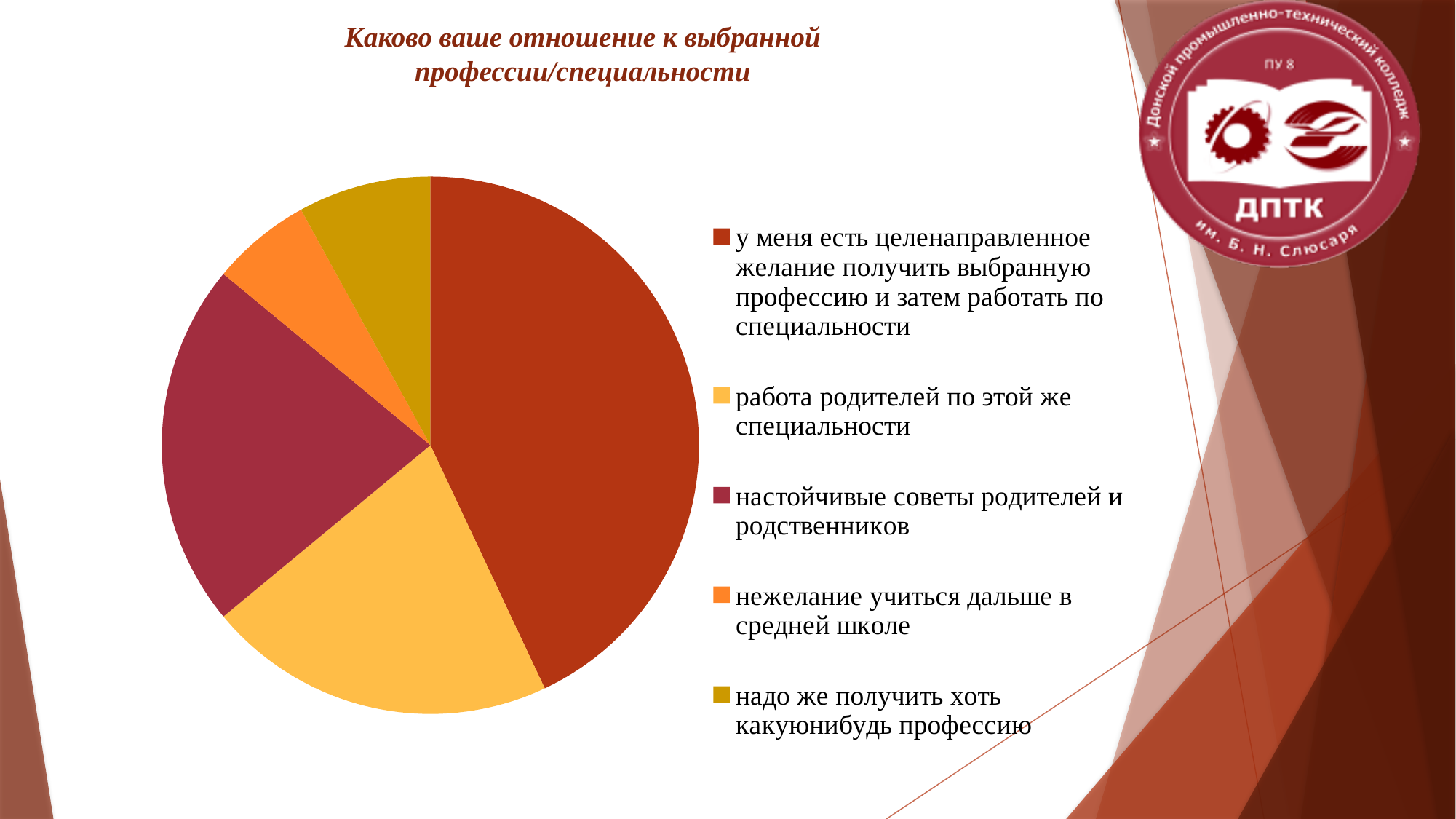
Which category has the largest slice of the pie? у меня есть целенаправленное желание получить выбранную профессию и затем работать по специальности Does the largest slice take up more or less than half of the pie? less Which slice is larger: 'работа родителей по этой же специальности' or 'нежелание учиться дальше в средней школе'? работа родителей по этой же специальности What kind of chart is shown on the slide? pie chart Which slice is larger: 'настойчивые советы родителей и родственников' or 'надо же получить хоть какуюнибудь профессию'? настойчивые советы родителей и родственников Which colour represents 'работа родителей по этой же специальности' in the legend? yellow What is the title of the chart? Каково ваше отношение к выбранной профессии/специальности How many entries does the legend list? 5 How many slices does the pie chart have? 5 Which slice is larger: 'у меня есть целенаправленное желание получить выбранную профессию и затем работать по специальности' or 'работа родителей по этой же специальности'? у меня есть целенаправленное желание получить выбранную профессию и затем работать по специальности